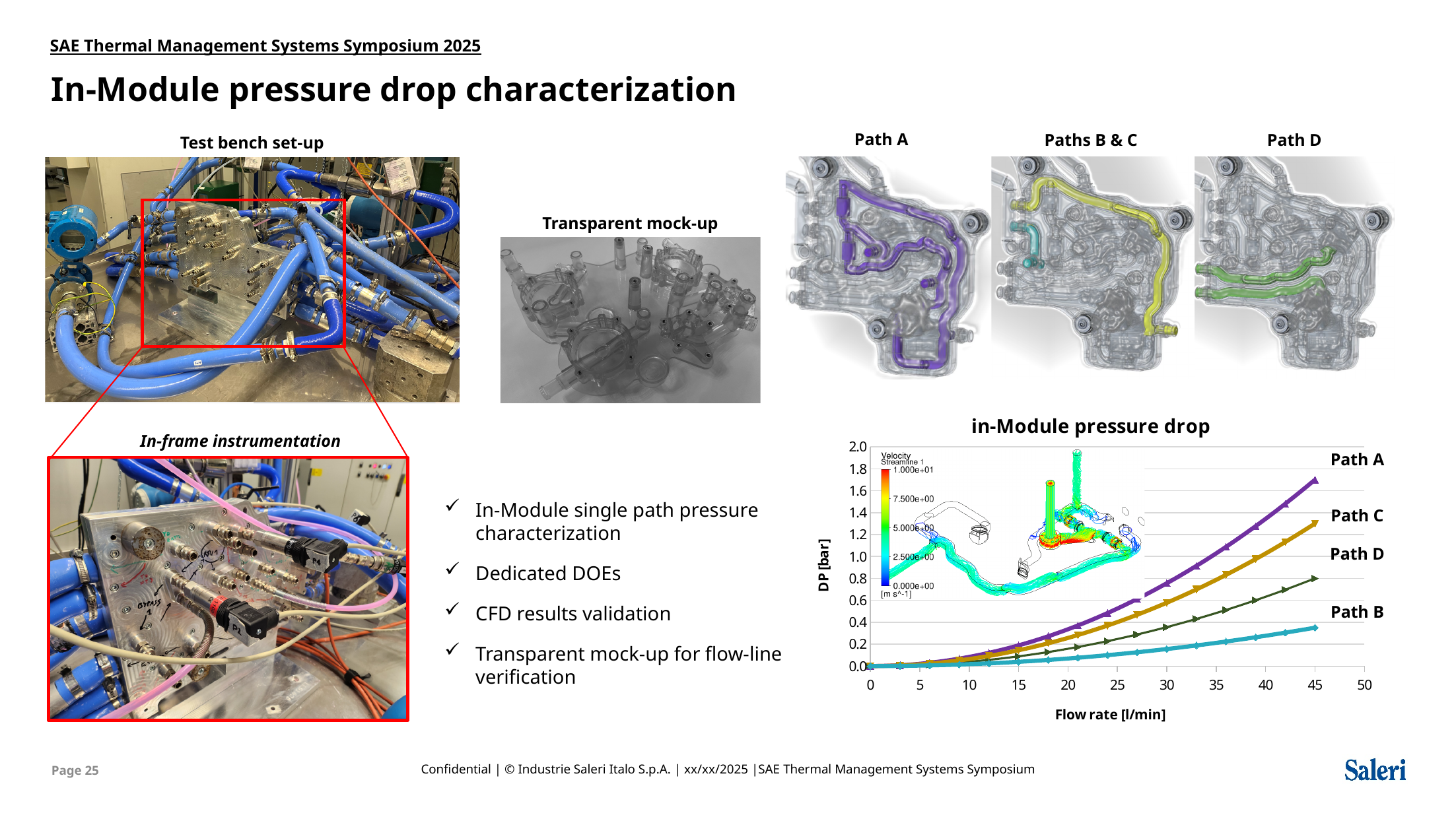
On the "in-Module pressure drop" chart, does the pressure drop for Path A rise or fall as flow rate increases? rise What is the y-axis label of the "in-Module pressure drop" chart? DP [bar] On the "in-Module pressure drop" chart, which has the larger pressure drop at 40 l/min, Path A or Path B? Path A On the "in-Module pressure drop" chart, which has the larger pressure drop at 45 l/min, Path C or Path D? Path C On the "in-Module pressure drop" chart, is the pressure drop for Path A at 45 l/min greater or less than 1.6 bar? greater On the "in-Module pressure drop" chart, is the pressure drop for Path B at 45 l/min greater or less than 0.6 bar? less On the "in-Module pressure drop" chart, which path has the lowest pressure drop at 45 l/min? Path B What is the x-axis label of the "in-Module pressure drop" chart? Flow rate [l/min] On the "in-Module pressure drop" chart, is the pressure drop for Path D at 45 l/min greater or less than 1.0 bar? less What kind of chart is the "in-Module pressure drop" chart? line chart On the "in-Module pressure drop" chart, which path has the highest pressure drop at 45 l/min? Path A How many paths (series) are plotted on the "in-Module pressure drop" chart? 4